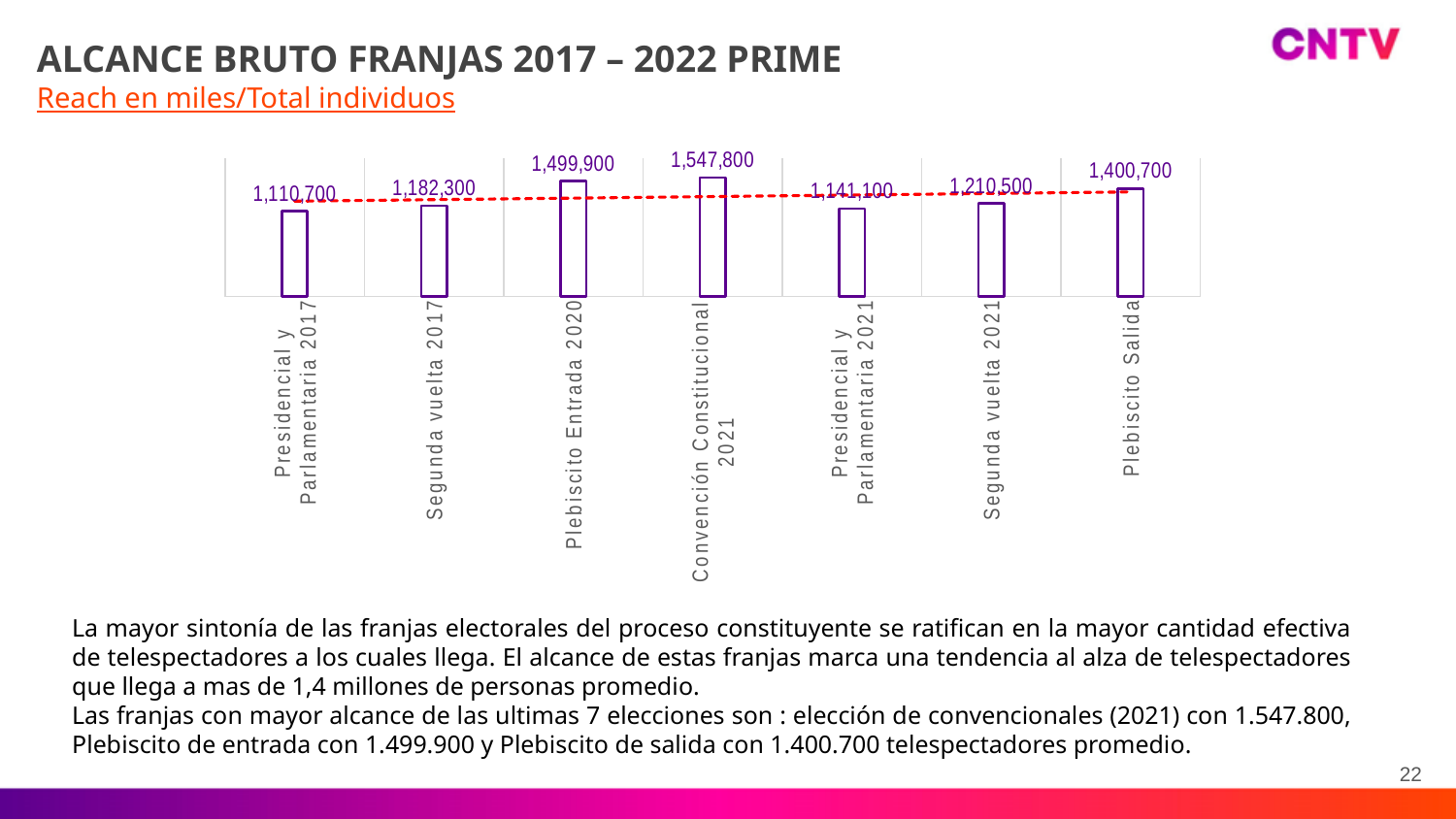
Which category has the highest value? Convención Constitucional 2021 What is the value for Plebiscito Salida? 1,400,700 What is the value for Presidencial y Parlamentaria 2021? 1,141,100 What is the difference between the values for Segunda vuelta 2021 and Presidencial y Parlamentaria 2021? 69,400 What is the value for Segunda vuelta 2021? 1,210,500 What kind of chart is shown on the slide? Bar chart What is the difference between the values for Convención Constitucional 2021 and Plebiscito Entrada 2020? 47,900 What is the title of the chart? ALCANCE BRUTO FRANJAS 2017 – 2022 PRIME How many categories are shown in the chart? 7 Which category has the lowest value? Presidencial y Parlamentaria 2017 Which is larger, the value for Segunda vuelta 2017 or the value for Segunda vuelta 2021? Segunda vuelta 2021 What is the value for Convención Constitucional 2021? 1,547,800